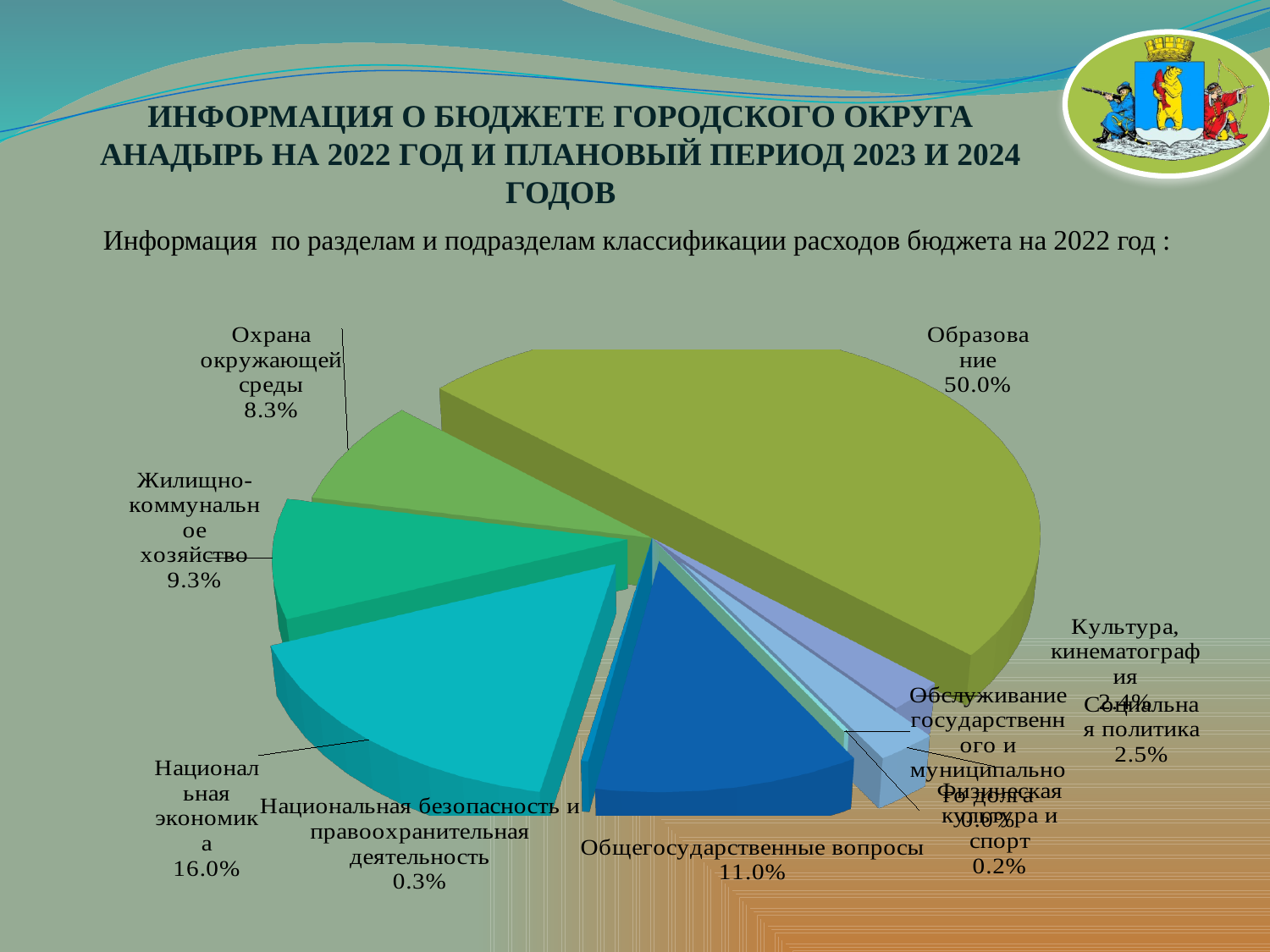
What is the value shown for Охрана окружающей среды? 8.3% What is the value shown for Общегосударственные вопросы? 11.0% Which year's budget expenditures does the pie chart describe? 2022 Which category has the largest slice of the pie? Образование What share of the 2022 budget expenditures goes to Образование? 50.0% Which is larger: Жилищно-коммунальное хозяйство or Охрана окружающей среды? Жилищно-коммунальное хозяйство What kind of chart is shown on the slide? pie chart What is the value shown for Национальная безопасность и правоохранительная деятельность? 0.3% Which is larger: Национальная экономика or Общегосударственные вопросы? Национальная экономика What is the difference between the shares of Образование and Национальная экономика? 34.0% What is the value shown for Национальная экономика? 16.0% What is the value shown for Жилищно-коммунальное хозяйство? 9.3%